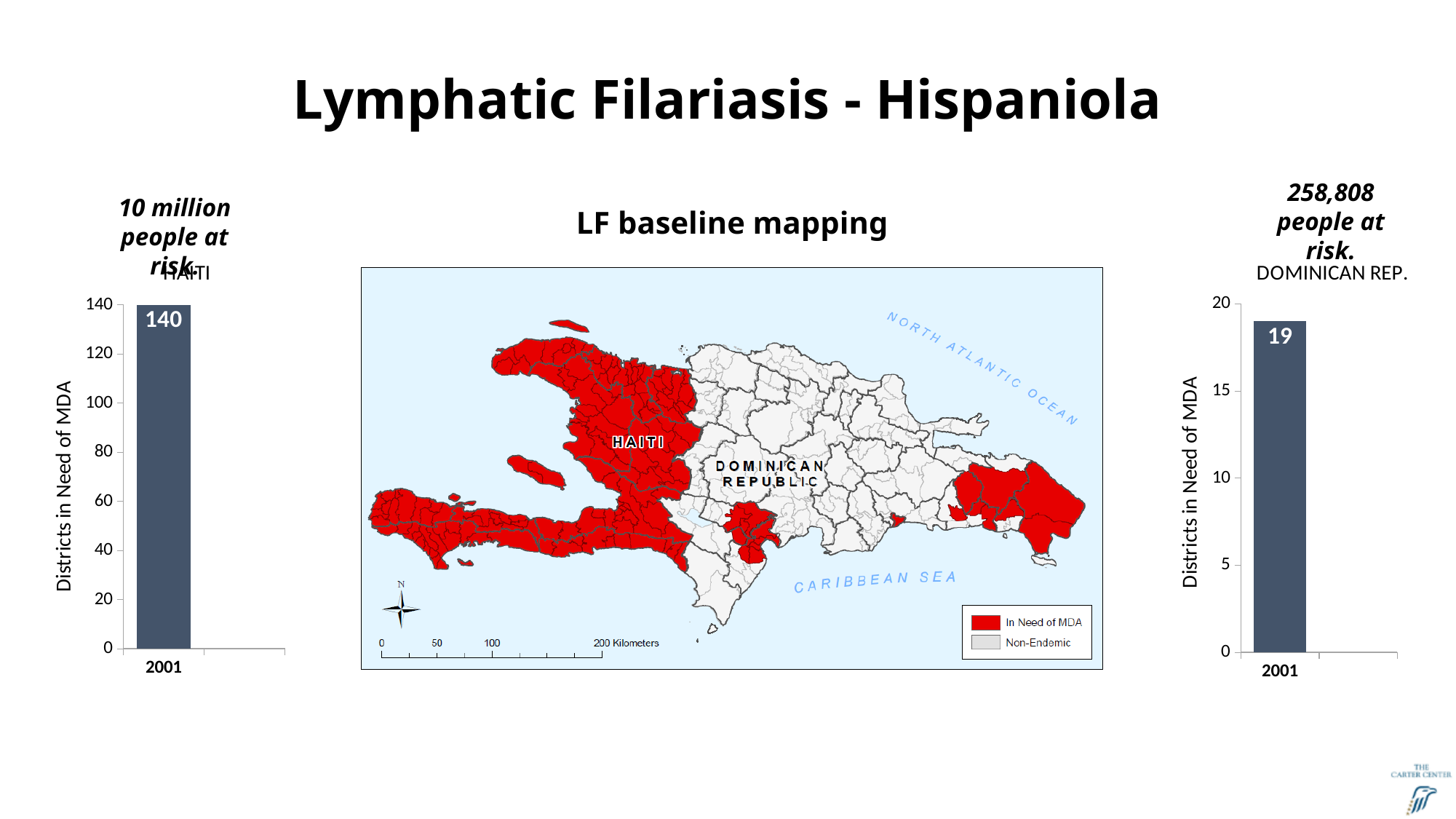
What is the y-axis label of the HAITI chart on the left? Districts in Need of MDA In the DOMINICAN REP. chart on the right, is the value for 2001 greater or less than 15? greater In the DOMINICAN REP. chart on the right, what is the value for 2001? 19 What is the difference between the 2001 value in the HAITI chart and the 2001 value in the DOMINICAN REP. chart? 121 In the HAITI chart on the left, what is the value for 2001? 140 How many bars are plotted in the DOMINICAN REP. chart on the right? 1 How many bars are plotted in the HAITI chart on the left? 1 What kind of chart is the HAITI chart on the left? bar chart In the HAITI chart on the left, is the value for 2001 greater or less than 100? greater What is the title of the chart on the right of the slide? DOMINICAN REP. What kind of chart is the DOMINICAN REP. chart on the right? bar chart Which is larger: the 2001 value in the HAITI chart or the 2001 value in the DOMINICAN REP. chart? HAITI